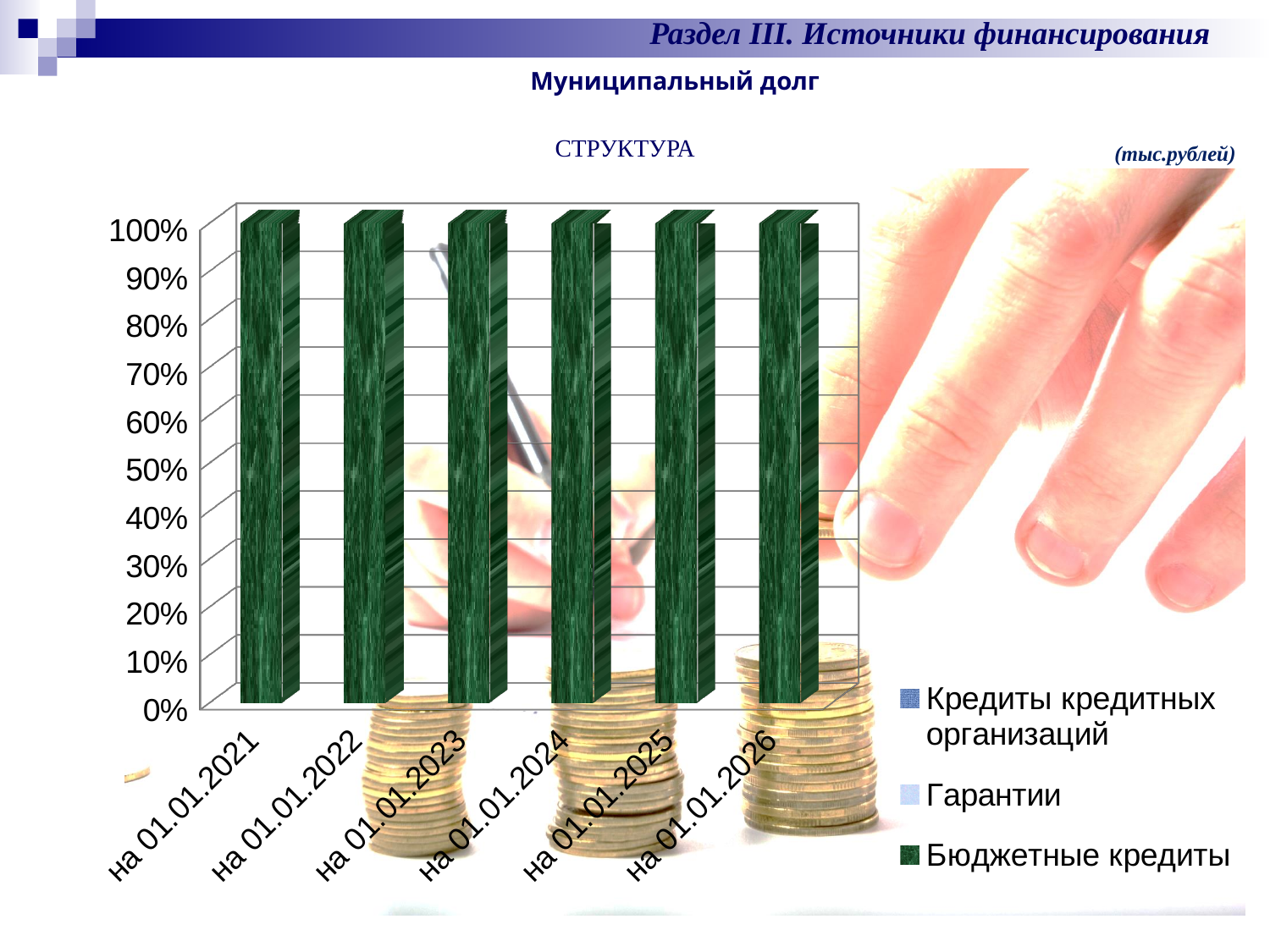
Is the value for Бюджетные кредиты at на 01.01.2023 greater or less than 50%? greater Is the value for Бюджетные кредиты at на 01.01.2026 greater or less than 90%? greater What is the title shown above the chart? СТРУКТУРА What is the total height of the stacked bar for на 01.01.2021? 100% What is the last category on the x axis of the chart? на 01.01.2026 What kind of chart is shown on the slide? bar chart How many series does the chart legend list? 3 How many dates (categories) are shown along the x axis of the chart? 6 Which legend entry is shown in dark green? Бюджетные кредиты What is the first category on the x axis of the chart? на 01.01.2021 What is the highest value shown on the vertical axis of the chart? 100% Do the bar heights rise, fall, or stay the same from на 01.01.2021 to на 01.01.2026? stay the same